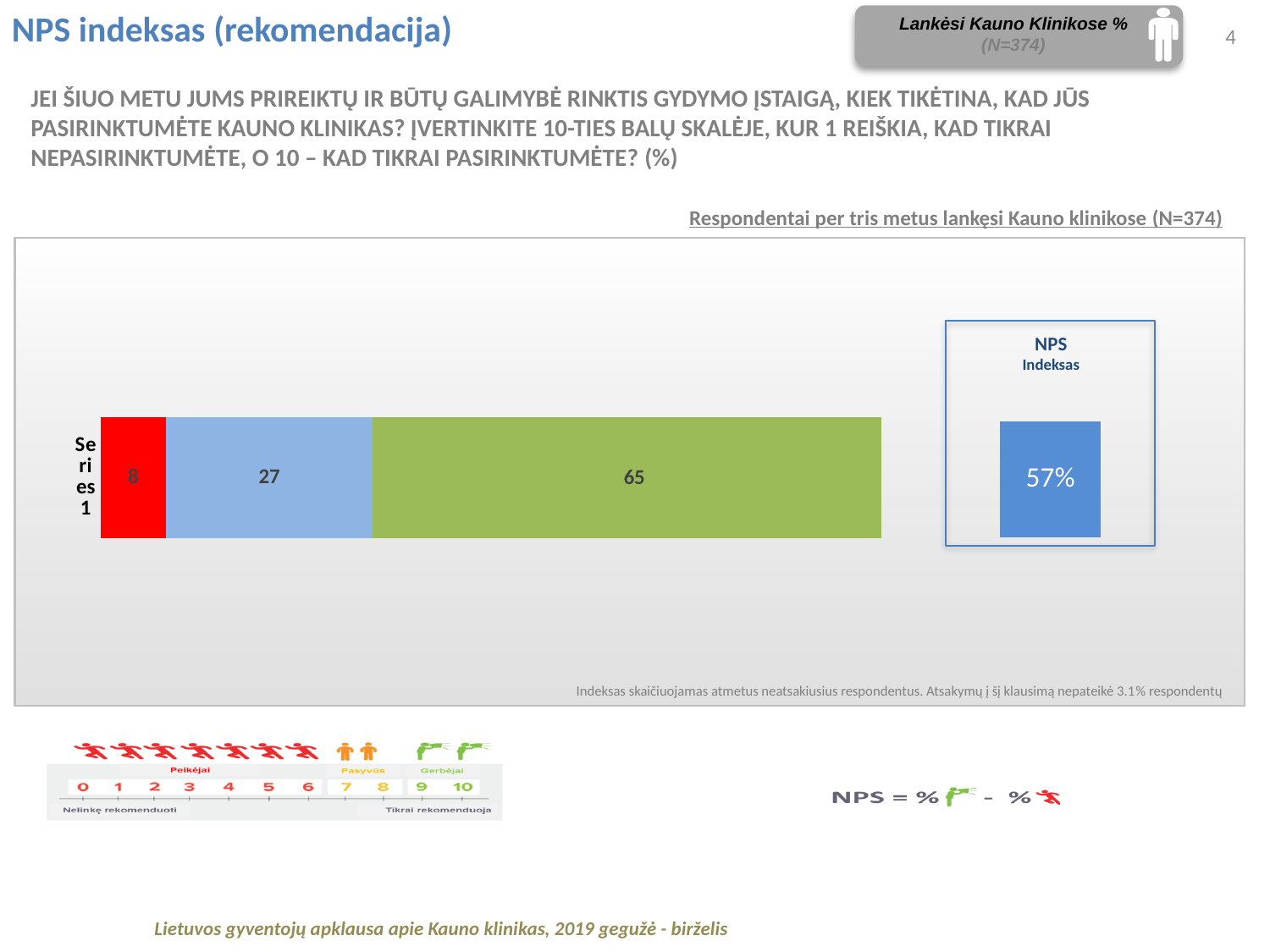
What is the value of the green segment of the stacked bar? 65 What is the total of the three segments in the stacked bar? 100 What type of chart is shown on the slide? Stacked bar chart Which is larger, the light blue segment or the green segment of the stacked bar? The green segment Which segment of the stacked bar has the smallest value? The red segment (8) What is the value of the light blue segment of the stacked bar? 27 What is the difference between the green segment and the red segment of the stacked bar? 57 What is the difference between the light blue segment and the red segment of the stacked bar? 19 How many segments make up the stacked bar? 3 What is the value of the red segment of the stacked bar? 8 What NPS index value is shown in the box to the right of the stacked bar? 57% Which segment of the stacked bar has the largest value? The green segment (65)